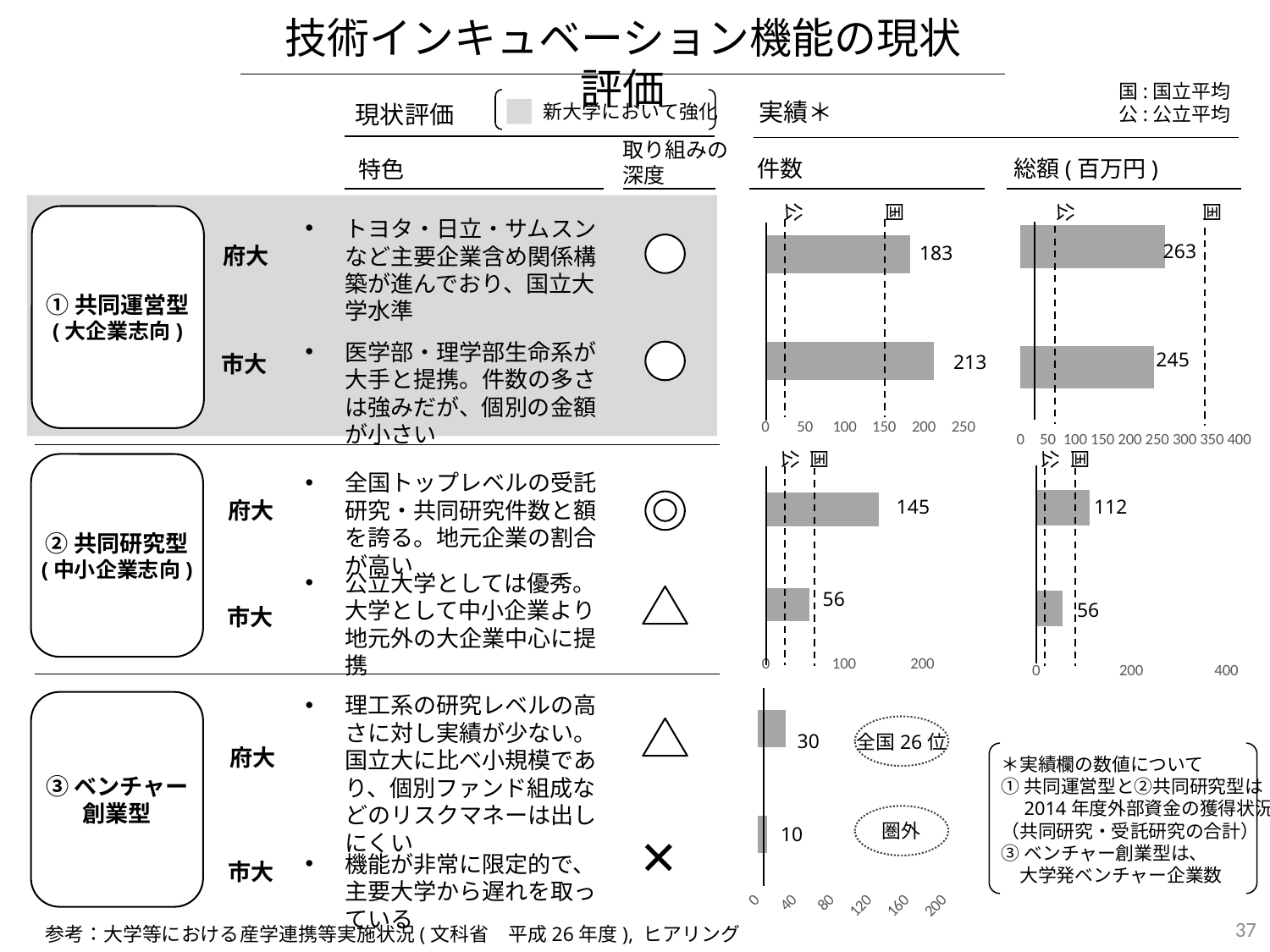
In the ②共同研究型 件数 chart, what is the value for 府大? 145 In the ①共同運営型 件数 chart, what is the value for 府大? 183 In the ②共同研究型 総額(百万円) chart, what is the value for 市大? 56 In the ②共同研究型 総額(百万円) chart, which is lower, 府大 or 市大? 市大 In the ①共同運営型 総額(百万円) chart, what is the value for 府大? 263 In the ②共同研究型 件数 chart, what is the difference between 府大 and 市大? 89 In the ③ベンチャー創業型 件数 chart, what is the total of 府大 and 市大? 40 What kind of chart is used to show the 件数 values for ①共同運営型? bar chart In the ①共同運営型 総額(百万円) chart, which is larger, 府大 or 市大? 府大 In the ①共同運営型 件数 chart, what is the value for 市大? 213 In the ③ベンチャー創業型 件数 chart, what is the value for 府大? 30 In the ①共同運営型 件数 chart, what is the difference between 市大 and 府大? 30